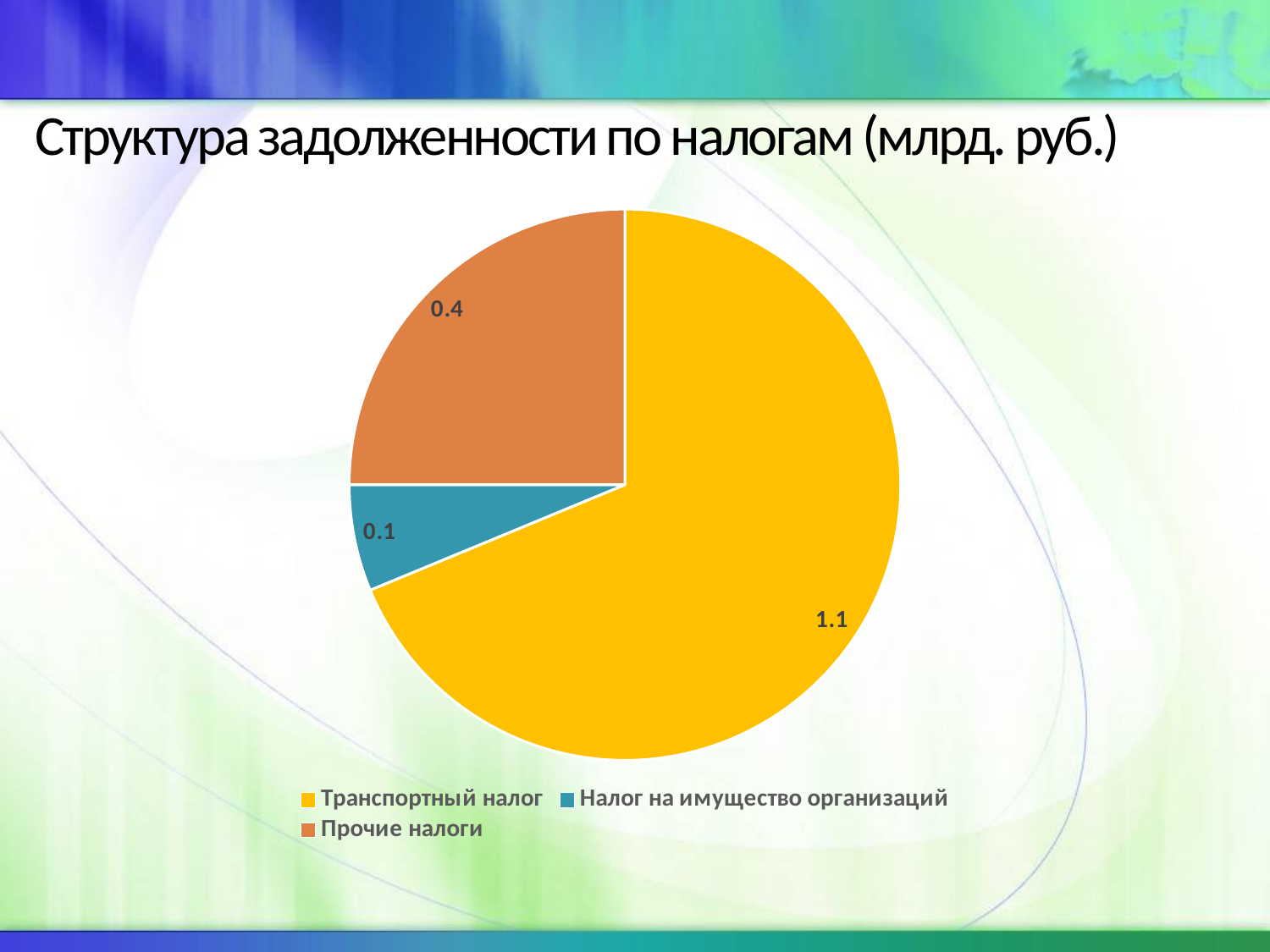
Which category has the largest slice of the pie? Транспортный налог What is the difference between the values for Транспортный налог and Прочие налоги? 0.7 Which is larger, the value for Прочие налоги or the value for Налог на имущество организаций? Прочие налоги Which category has the smallest slice of the pie? Налог на имущество организаций What type of chart is shown on the slide? Pie chart What is the value for Налог на имущество организаций? 0.1 What is the value for Транспортный налог? 1.1 What is the title of the chart? Структура задолженности по налогам (млрд. руб.) What is the total of all slices in the pie chart? 1.6 What is the value for Прочие налоги? 0.4 How many slices does the pie chart have? 3 What is the difference between the values for Прочие налоги and Налог на имущество организаций? 0.3